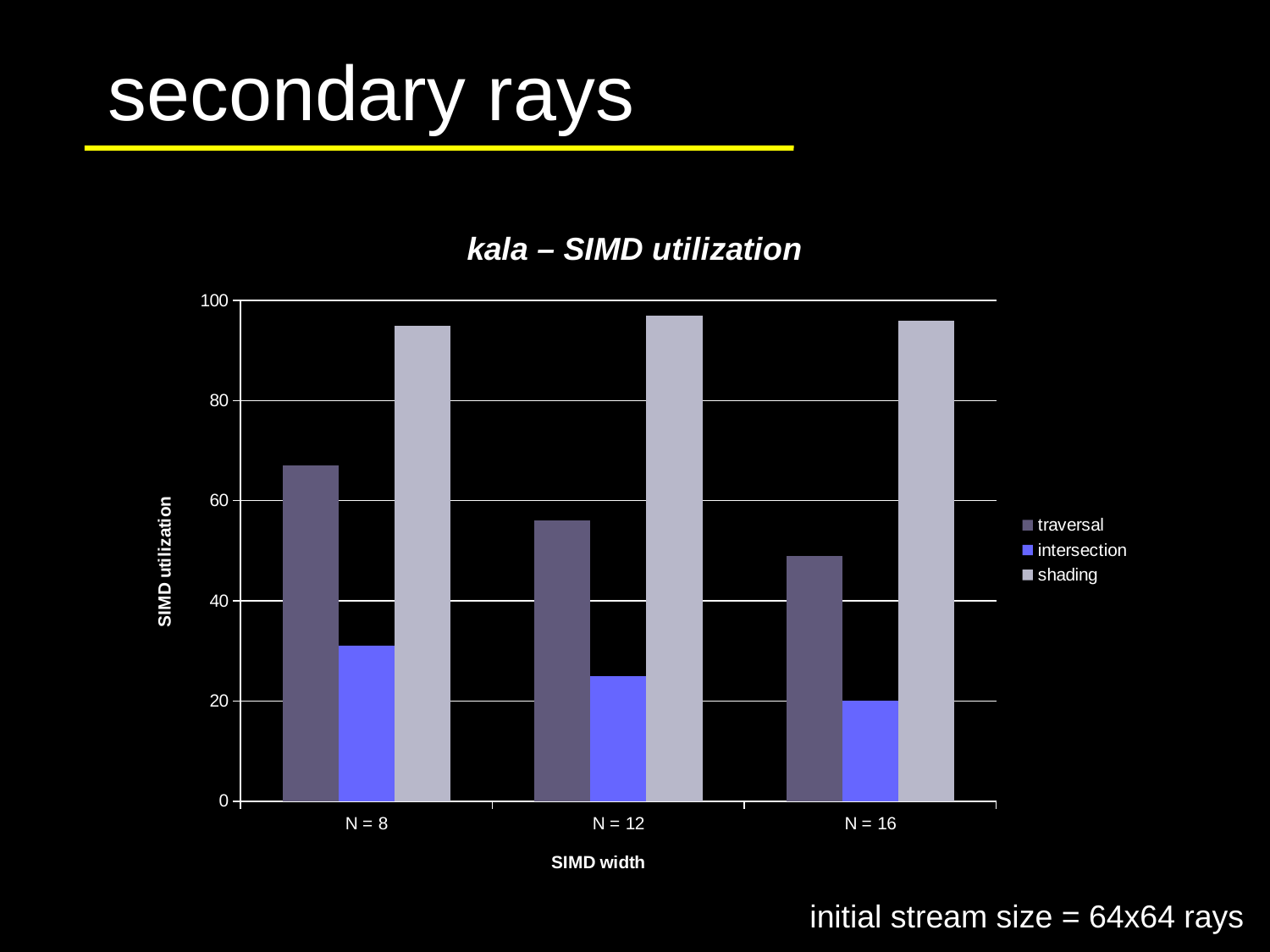
Which series has the lowest SIMD utilization at N = 16? intersection Is the traversal value for N = 16 greater or less than 60? less Is the traversal value for N = 8 greater or less than 60? greater Which is larger, the traversal value at N = 8 or the traversal value at N = 16? N = 8 What is the title of the chart? kala – SIMD utilization Does the intersection series rise or fall as SIMD width increases from N = 8 to N = 16? fall What kind of chart is shown on the slide? bar chart Is the shading value for N = 12 greater or less than 80? greater How many series does the legend list? 3 Which series has the highest SIMD utilization at N = 8? shading How many SIMD width categories are shown on the x axis? 3